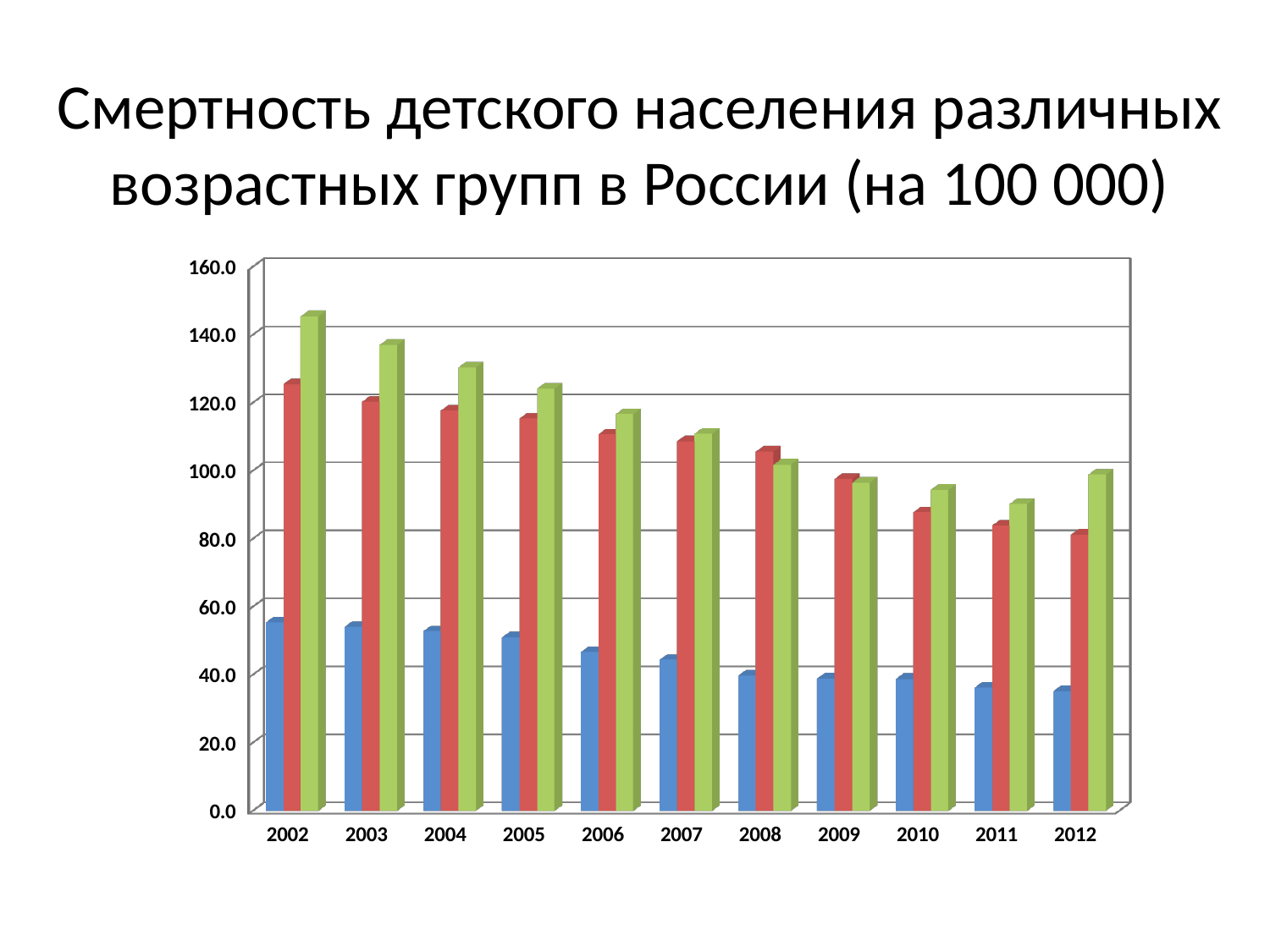
Is the value of the blue bar for 2012 greater or less than 40? less Do the values of the blue bars rise or fall from 2002 to 2012? fall How many bars are shown for each year in the chart? 3 How many years are shown on the x axis of the chart? 11 Is the value of the green bar for 2002 greater or less than 140? greater In 2012, which bar is larger, the red one or the green one? green What kind of chart is shown on the slide? bar chart What is the title of the chart on the slide? Смертность детского населения различных возрастных групп в России (на 100 000) Is the value of the blue bar for 2002 greater or less than 60? less In which year is the green bar the highest? 2002 In which year is the blue bar the highest? 2002